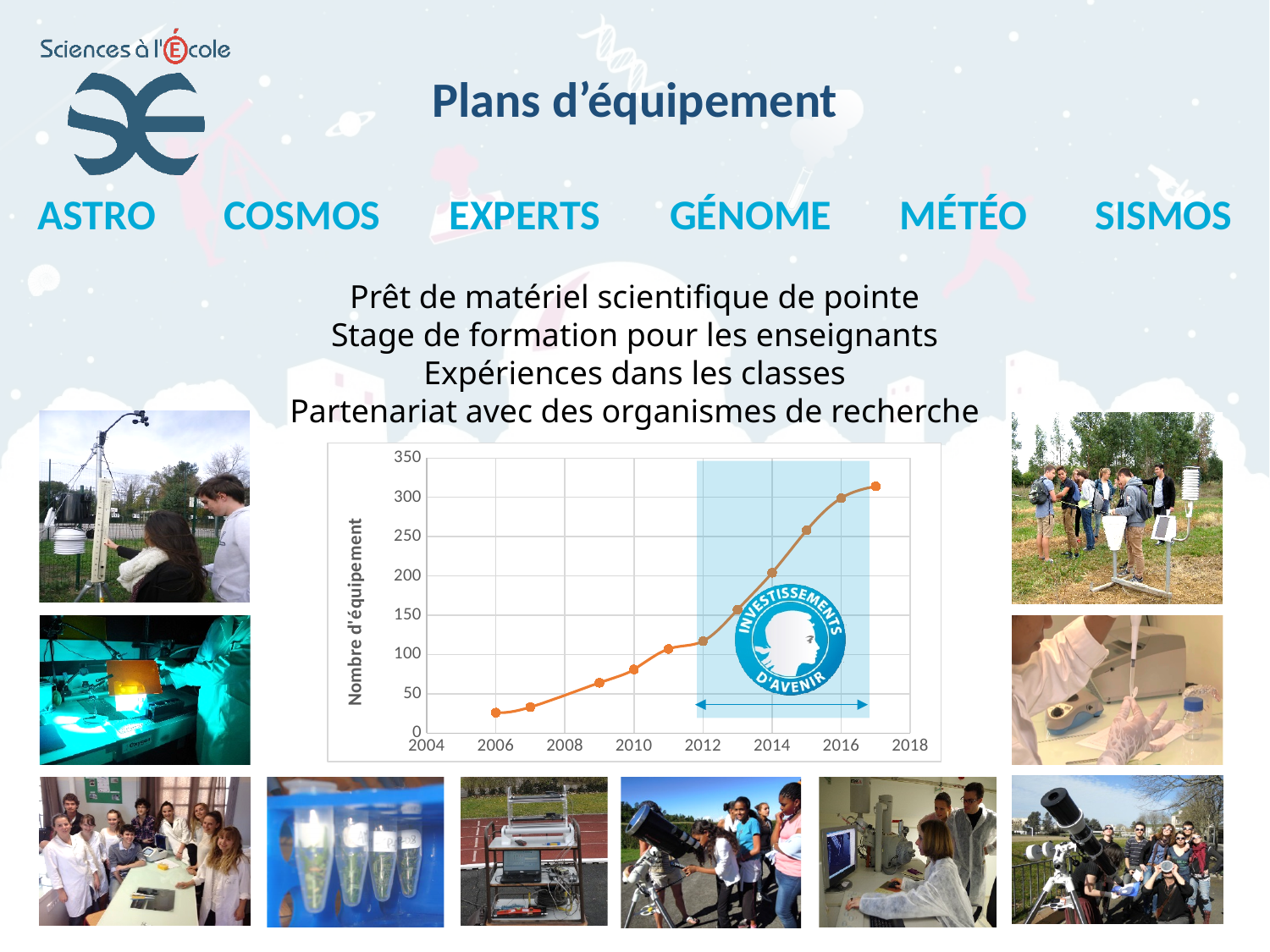
Do the values in the chart rise or fall from 2006 to 2017? rise Which year has the larger value, 2012 or 2016? 2016 Is the value for 2006 greater or less than 50? less What is the label of the vertical axis of the chart? Nombre d'équipement What kind of chart is shown on the slide? line chart Is the value for 2014 greater or less than 250? less Is the value for 2010 greater or less than 100? less Which year has the highest value in the chart? 2017 Which year has the lowest value in the chart? 2006